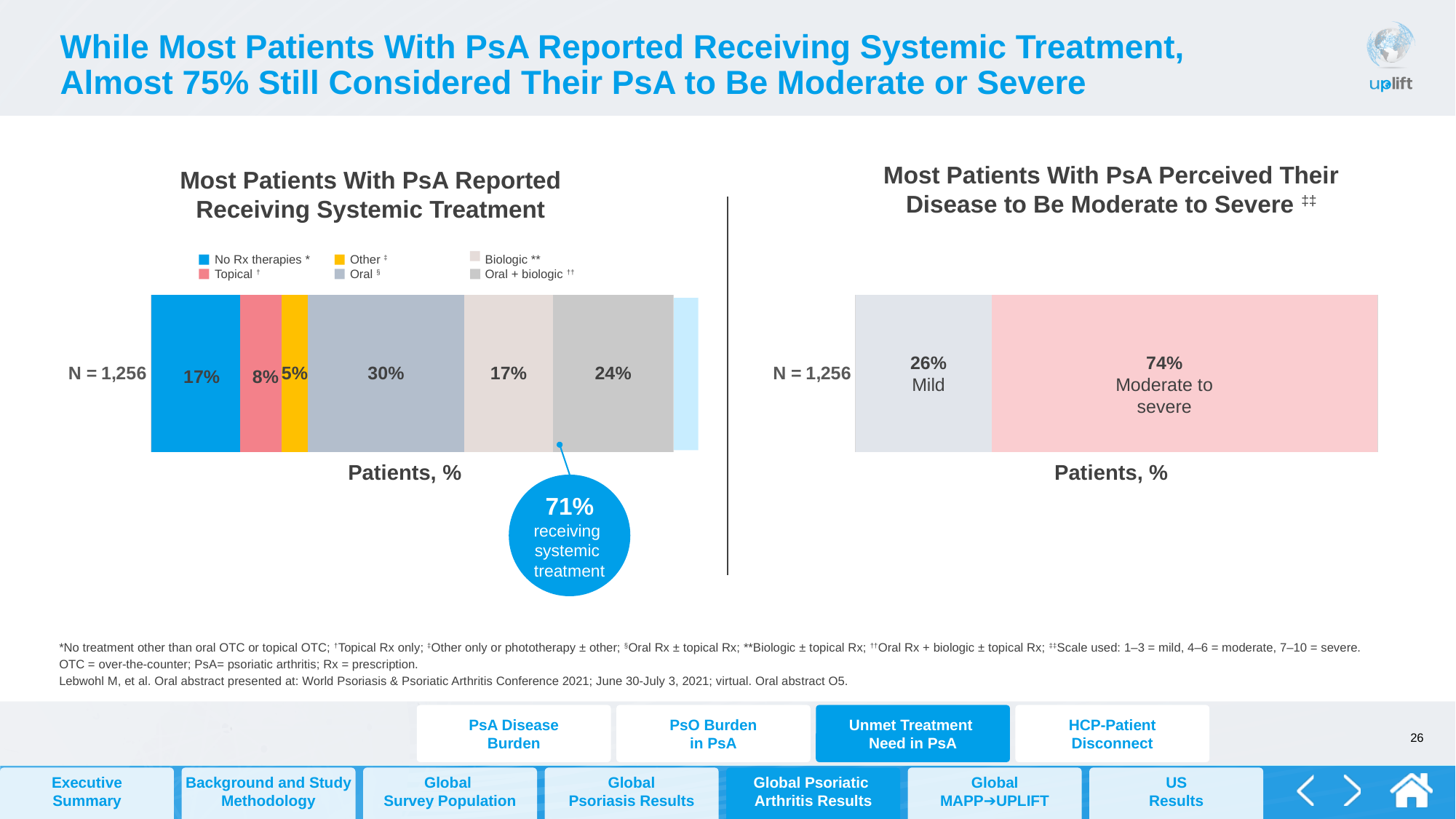
In the chart titled 'Most Patients With PsA Perceived Their Disease to Be Moderate to Severe', what percentage of patients rated their disease as moderate to severe? 74% In the chart titled 'Most Patients With PsA Reported Receiving Systemic Treatment', what percentage of patients reported oral treatment? 30% In the chart titled 'Most Patients With PsA Reported Receiving Systemic Treatment', what is the difference in percentage points between the oral segment and the topical segment? 22 In the chart titled 'Most Patients With PsA Reported Receiving Systemic Treatment', which treatment category has the largest share of patients? Oral In the chart titled 'Most Patients With PsA Reported Receiving Systemic Treatment', what percentage of patients reported no Rx therapies? 17% In the chart titled 'Most Patients With PsA Reported Receiving Systemic Treatment', how many treatment categories does the legend list? 6 In the chart titled 'Most Patients With PsA Reported Receiving Systemic Treatment', what percentage of patients are reported as receiving systemic treatment according to the callout? 71% In the chart titled 'Most Patients With PsA Reported Receiving Systemic Treatment', which treatment category has the smallest share of patients? Other In the chart titled 'Most Patients With PsA Reported Receiving Systemic Treatment', what percentage of patients reported oral + biologic treatment? 24% In the chart titled 'Most Patients With PsA Perceived Their Disease to Be Moderate to Severe', which is larger: the mild segment or the moderate to severe segment? Moderate to severe In the chart titled 'Most Patients With PsA Perceived Their Disease to Be Moderate to Severe', what percentage of patients rated their disease as mild? 26% What type of chart is used on the right side of the slide to show perceived disease severity? Stacked bar chart